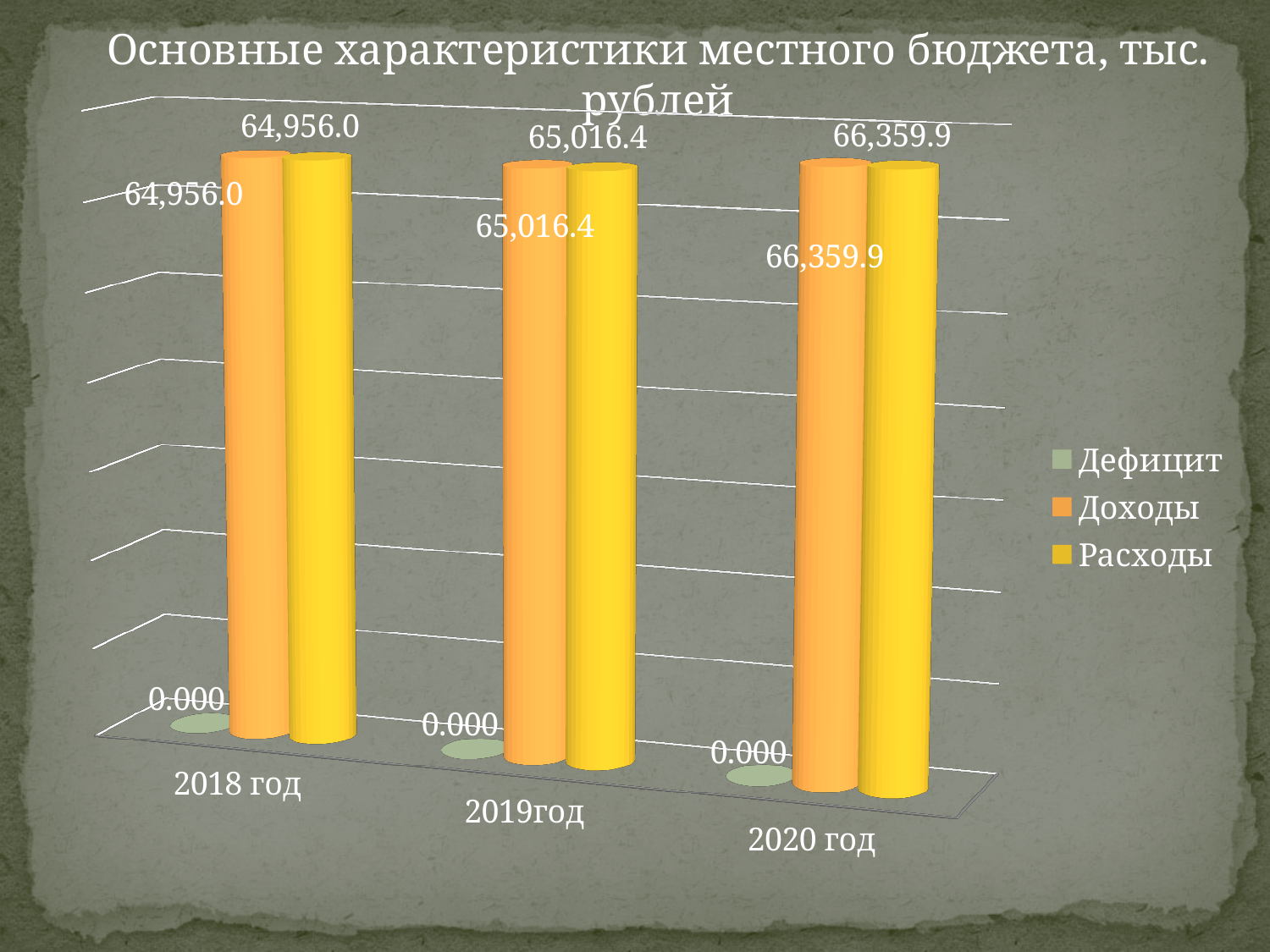
How many years are shown on the x axis? 3 In which year is Доходы the highest? 2020 год What is the value of Доходы for 2019год? 65,016.4 What is the value of Расходы for 2020 год? 66,359.9 Which is larger: Расходы in 2019год or Расходы in 2018 год? Расходы in 2019год How many series does the legend list? 3 What is the difference between Доходы in 2020 год and Доходы in 2018 год? 1,403.9 What is the value of Доходы for 2018 год? 64,956.0 What kind of chart is shown on the slide? Bar chart In which year is Расходы the lowest? 2018 год Do the Доходы values rise or fall from 2018 год to 2020 год? Rise What is the value of Дефицит for 2019год? 0.000